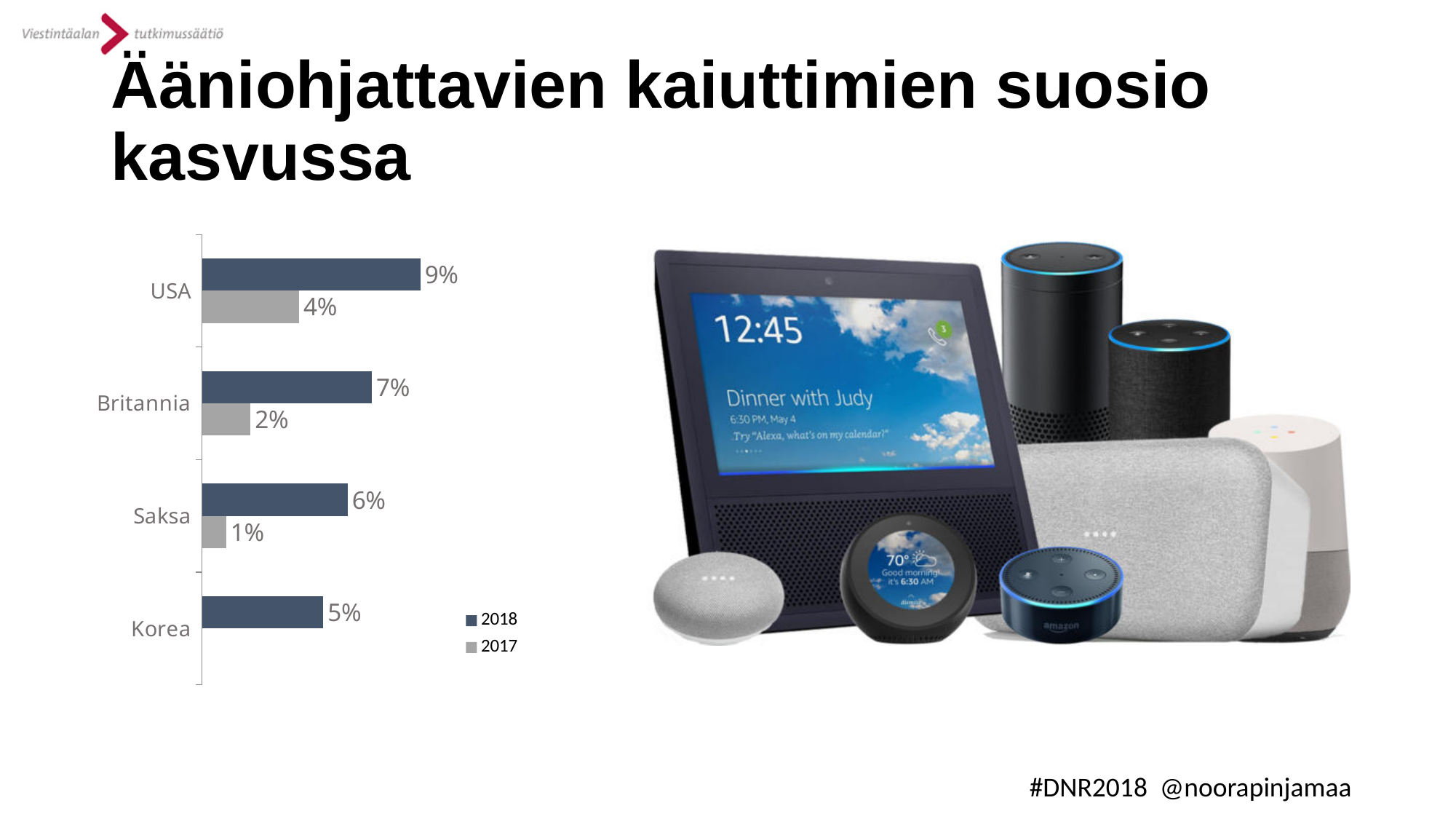
What is the difference between the 2018 values for Britannia and Korea? 2% How many series does the legend list? 2 What is the difference between the 2018 and 2017 values for USA? 5% What is the 2018 value for Korea? 5% Which country has the lowest 2017 value shown? Saksa What kind of chart is shown on the slide? Bar chart What is the 2018 value for USA? 9% What is the 2018 value for Saksa? 6% Which is larger, the 2018 value for Saksa or the 2018 value for Korea? Saksa What is the 2017 value for Britannia? 2% How many countries are shown on the chart? 4 Which country has the highest 2018 value? USA